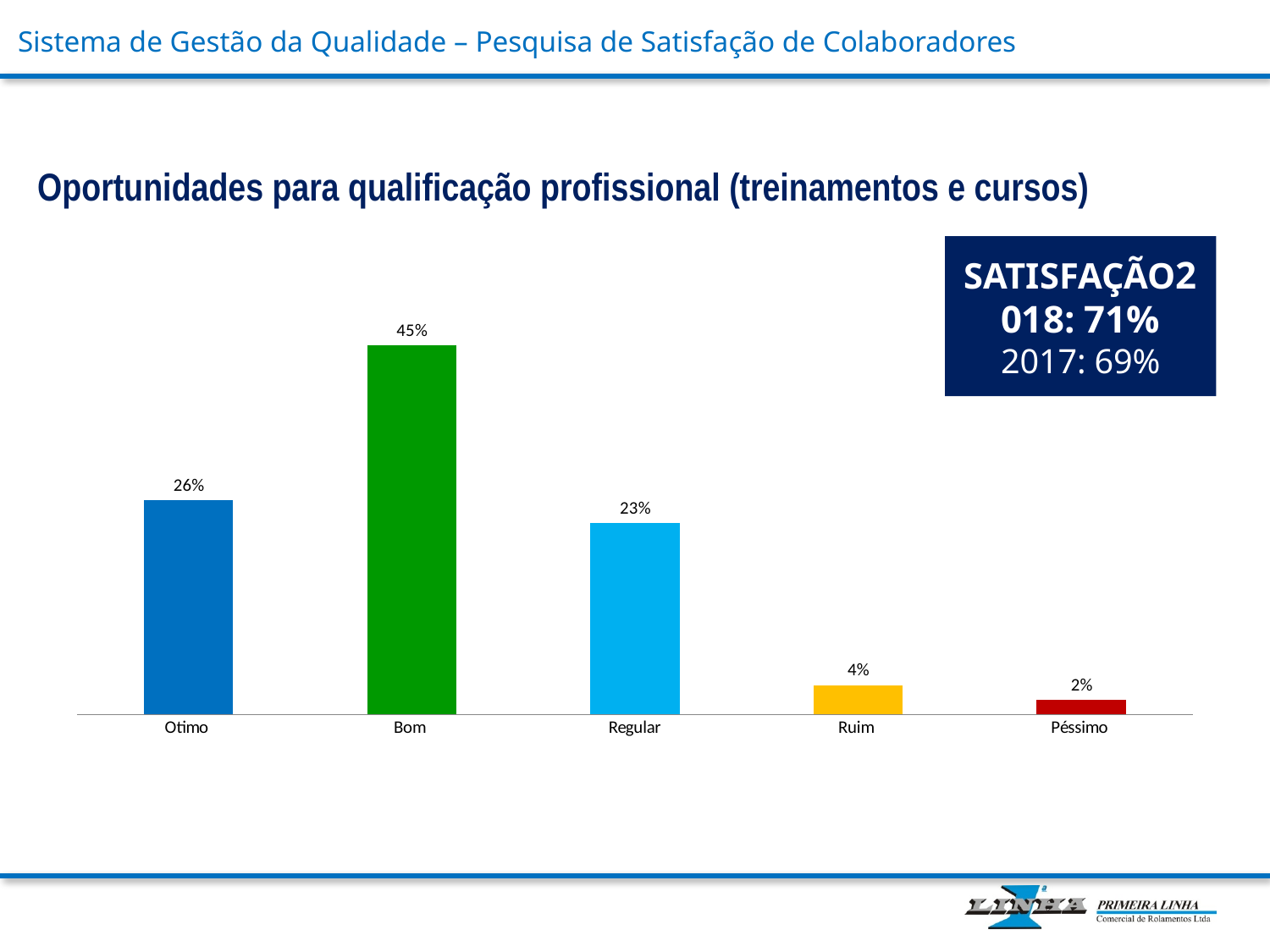
Which category has the lowest value? Péssimo What is the value for Otimo? 26% What is the value for Regular? 23% How many categories are shown on the x axis? 5 What is the value for Ruim? 4% Which is larger, the value for Otimo or the value for Regular? Otimo What kind of chart is shown on the slide? Bar chart What is the difference between the values for Bom and Otimo? 19% Which category has the highest value? Bom What colour is the bar for Bom? Green What is the value for Bom? 45% What is the value for Péssimo? 2%